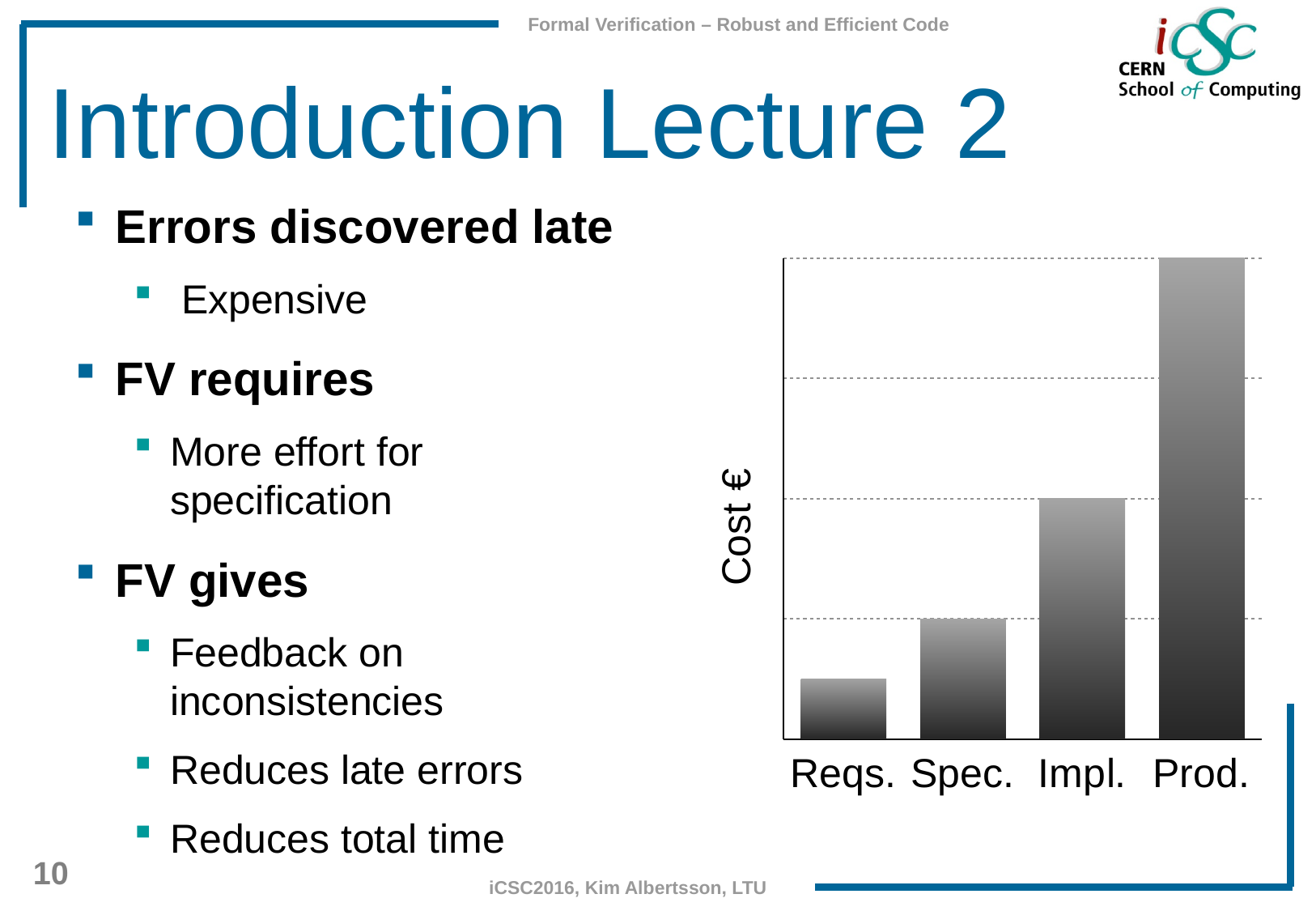
Which category has the highest bar in the chart? Prod. How many categories are shown on the x axis of the chart? 4 Which is larger in the chart, the value for Reqs. or the value for Prod.? Prod. Which is larger in the chart, the value for Impl. or the value for Spec.? Impl. What is the label of the third category from the left on the x axis? Impl. What is the label on the vertical axis of the chart? Cost € Which category has the lowest bar in the chart? Reqs. Do the bar values rise or fall from Reqs. to Prod. along the x axis? rise What kind of chart is shown on the slide? bar chart